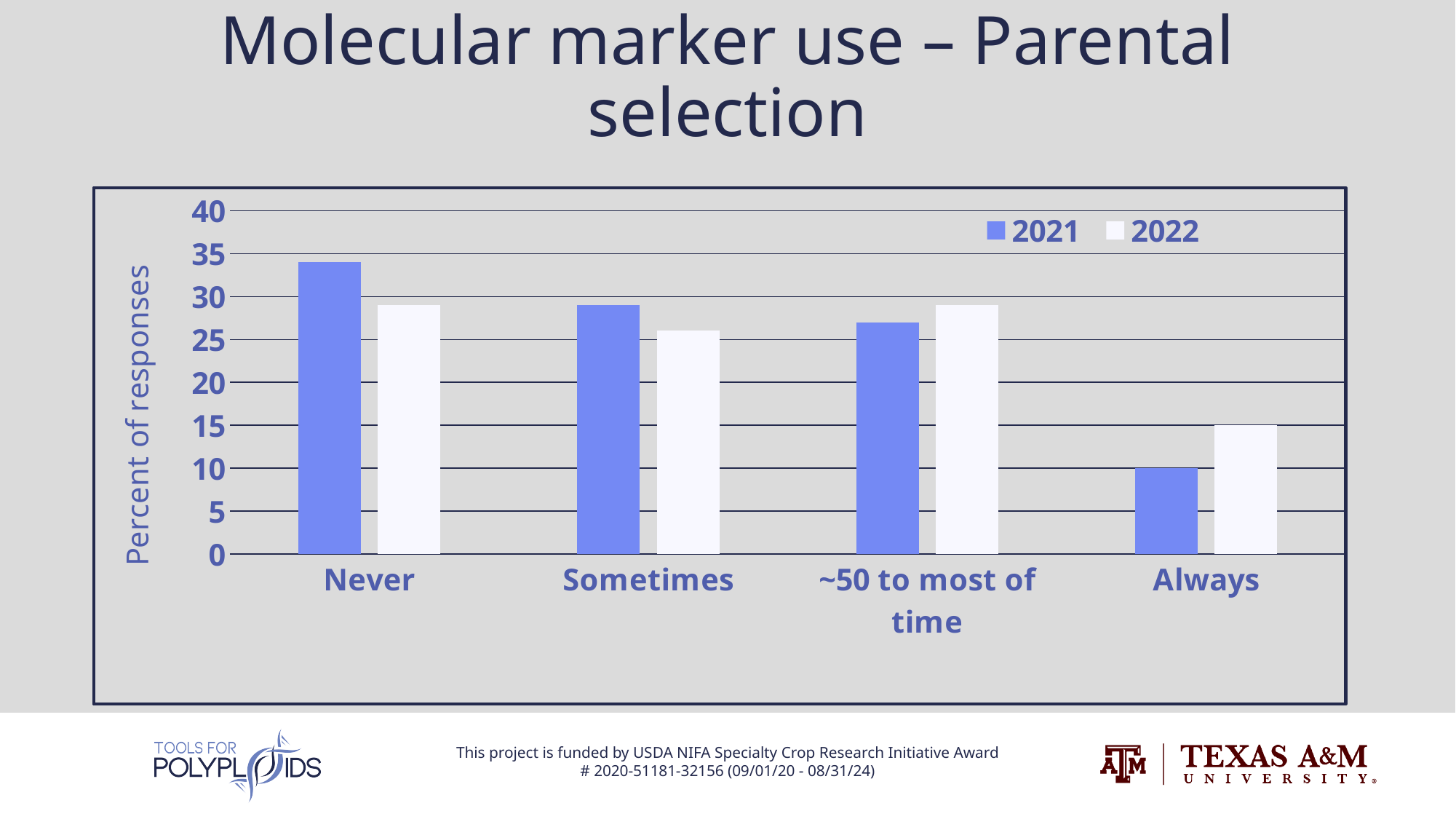
Is the 2021 value for Never greater or less than 30? greater How many series does the legend list? 2 Which category has the lowest value for 2022? Always How many categories are shown on the x axis? 4 Is the 2021 value for ~50 to most of time greater or less than 25? greater What is the label on the y axis? Percent of responses What kind of chart is shown on the slide? bar chart Which category has the highest value for 2021? Never For the Never category, which series has the larger value, 2021 or 2022? 2021 Is the 2022 value for Sometimes greater or less than 30? less Which category has the lowest value for 2021? Always For the Always category, which series has the larger value, 2021 or 2022? 2022